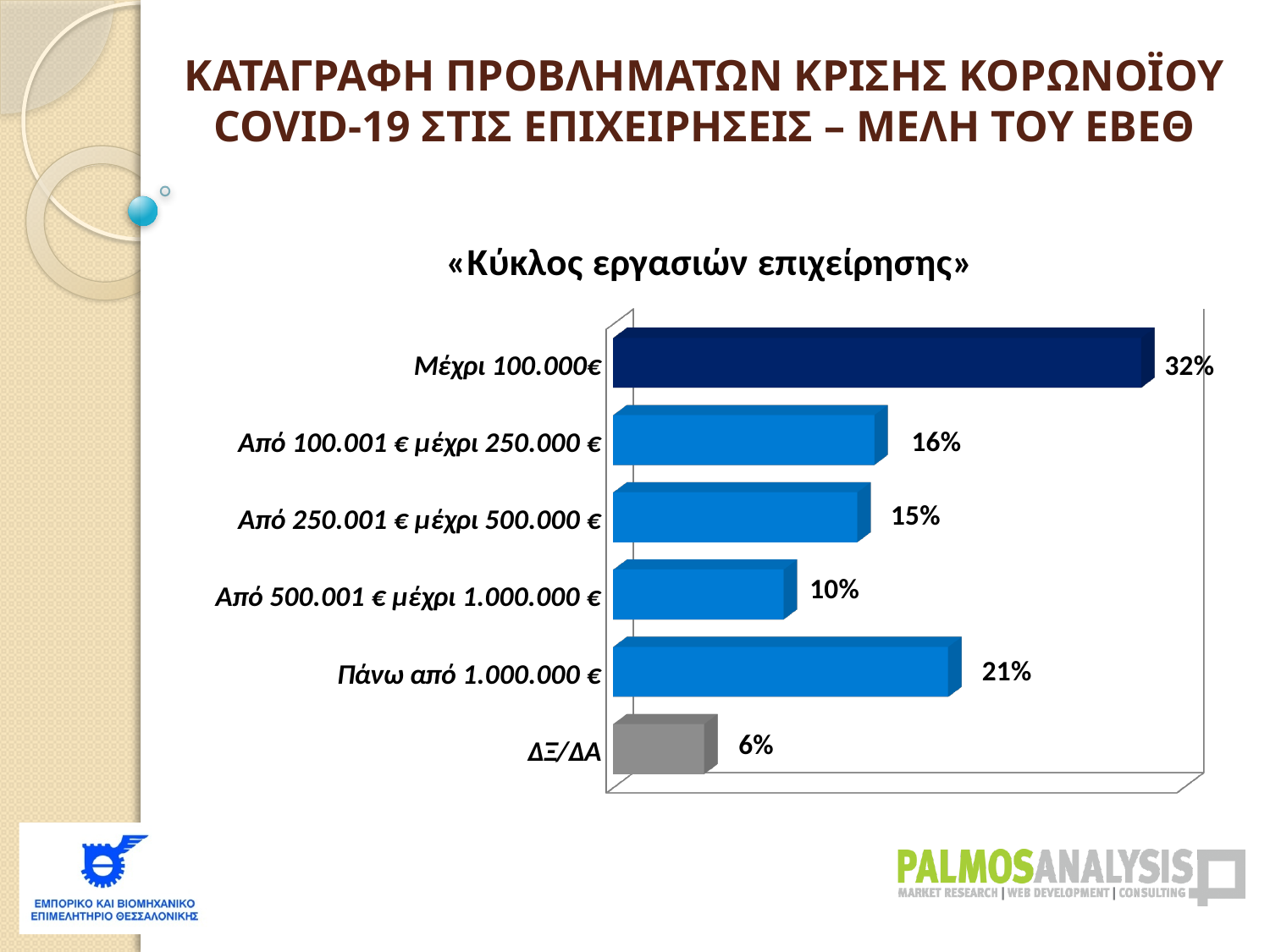
What is the value for «Μέχρι 100.000€»? 32% What is the title of the chart? «Κύκλος εργασιών επιχείρησης» What is the difference between the values for «Μέχρι 100.000€» and «Πάνω από 1.000.000 €»? 11% Which category has the lowest value? ΔΞ/ΔΑ What is the value for «ΔΞ/ΔΑ»? 6% What is the value for «Από 100.001 € μέχρι 250.000 €»? 16% Which is larger: the value for «Από 250.001 € μέχρι 500.000 €» or «Από 500.001 € μέχρι 1.000.000 €»? Από 250.001 € μέχρι 500.000 € Which category has the highest value? Μέχρι 100.000€ What is the value for «Πάνω από 1.000.000 €»? 21% What colour is the bar for «ΔΞ/ΔΑ»? Grey How many categories are shown in the chart? 6 What kind of chart is shown on the slide? Bar chart